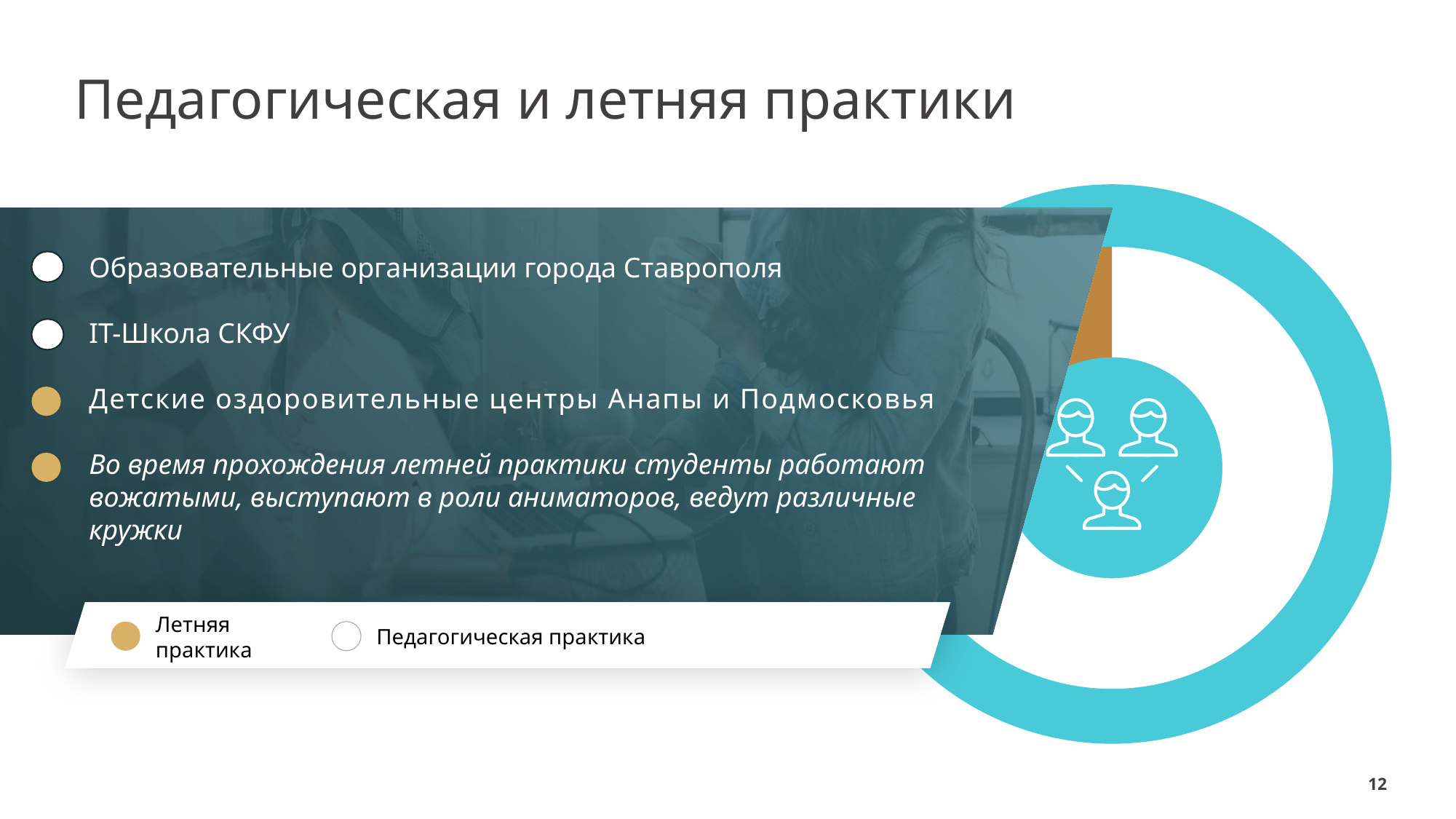
Which two categories are listed in the chart's legend? Летняя практика, Педагогическая практика Which category occupies the smaller share of the doughnut chart? Летняя практика Which legend category is shown in gold colour? Летняя практика What kind of chart is shown on the right side of the slide? pie (doughnut) chart How many categories does the legend of the chart list? 2